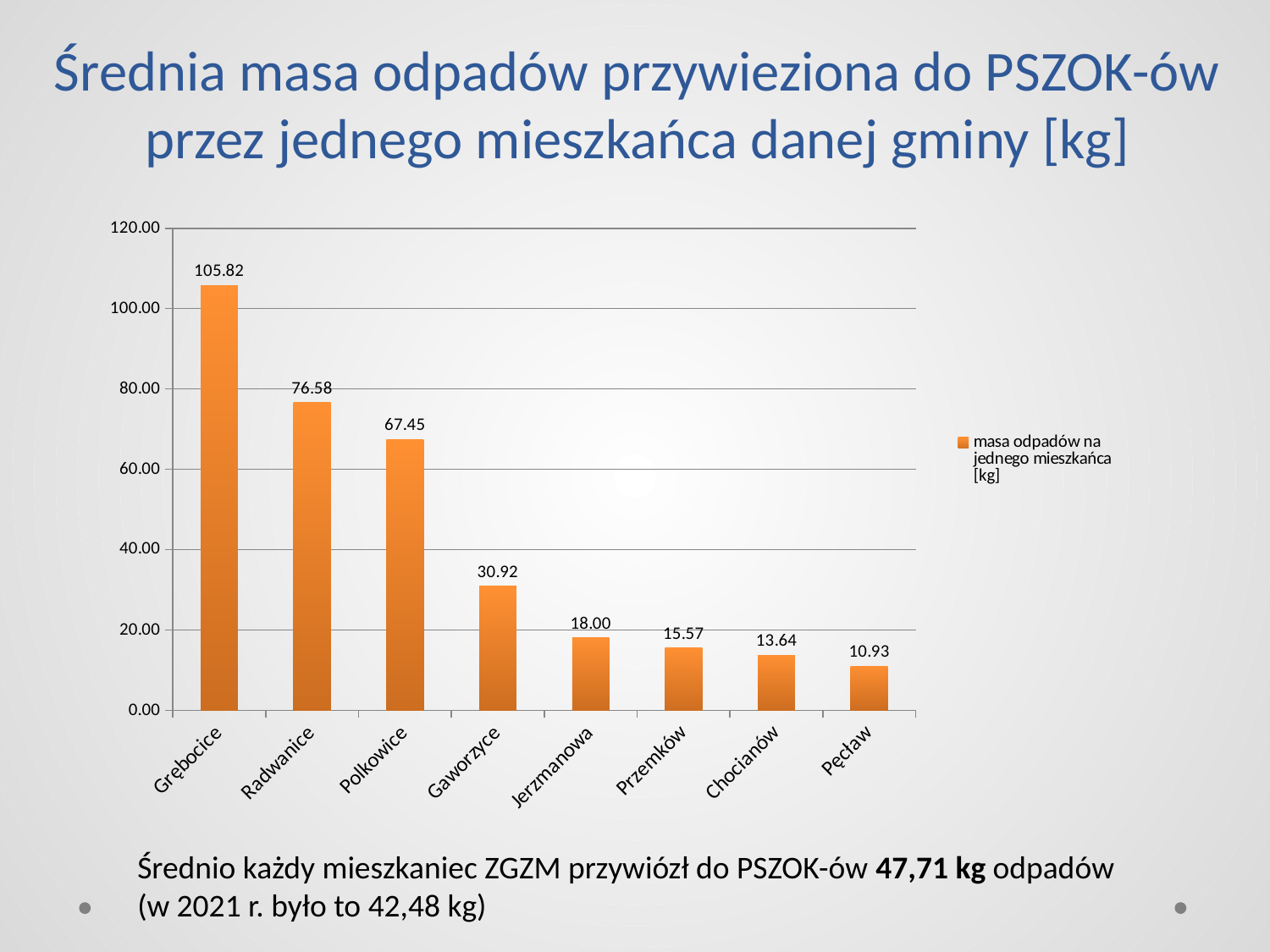
What is the difference between the values for Radwanice and Polkowice? 9.13 Which is larger, the value for Jerzmanowa or the value for Przemków? Jerzmanowa How many categories are shown on the x axis? 8 Is the value for Polkowice greater or less than 60.00? greater Do the values rise or fall from left to right along the x axis? fall What kind of chart is shown on the slide? bar chart Which category has the highest value? Grębocice Which category has the lowest value? Pęcław What is the value for Gaworzyce? 30.92 What is the value for Chocianów? 13.64 How many series does the legend list? 1 What is the value for Grębocice? 105.82